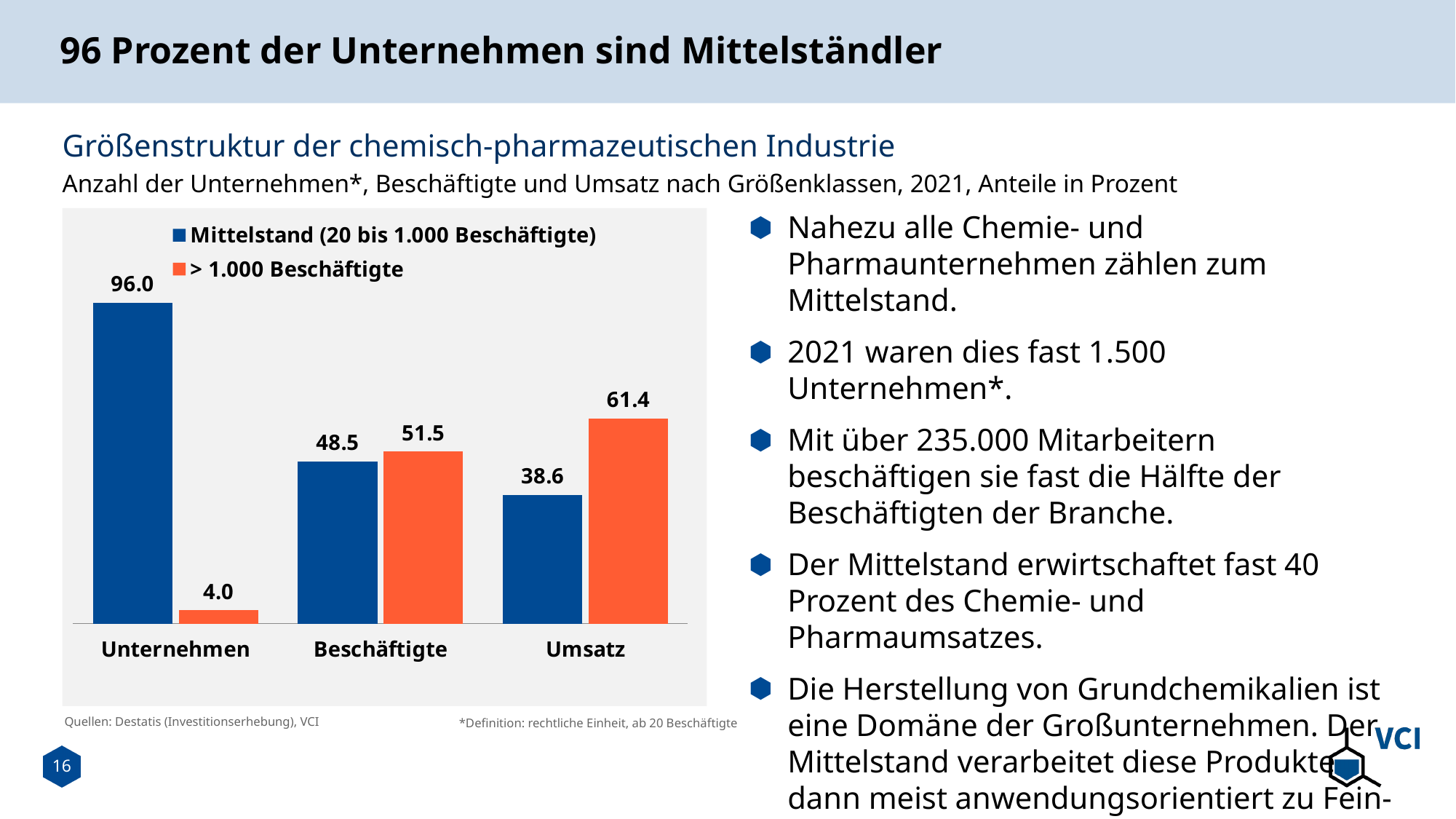
What is the difference between the Mittelstand and > 1.000 Beschäftigte values in the Unternehmen category? 92.0 What is the difference between the Mittelstand and > 1.000 Beschäftigte values in the Umsatz category? 22.8 What is the value for > 1.000 Beschäftigte in the Unternehmen category? 4.0 In which category does the Mittelstand (20 bis 1.000 Beschäftigte) series have its highest value? Unternehmen What is the value for Mittelstand (20 bis 1.000 Beschäftigte) in the Beschäftigte category? 48.5 What is the value for > 1.000 Beschäftigte in the Umsatz category? 61.4 How many series does the chart legend list? 2 What is the value for Mittelstand (20 bis 1.000 Beschäftigte) in the Unternehmen category? 96.0 In which category does the > 1.000 Beschäftigte series have its lowest value? Unternehmen In the Beschäftigte category, which series has the larger value: Mittelstand (20 bis 1.000 Beschäftigte) or > 1.000 Beschäftigte? > 1.000 Beschäftigte What kind of chart is shown on the slide? Bar chart How many categories are shown on the x axis of the chart? 3